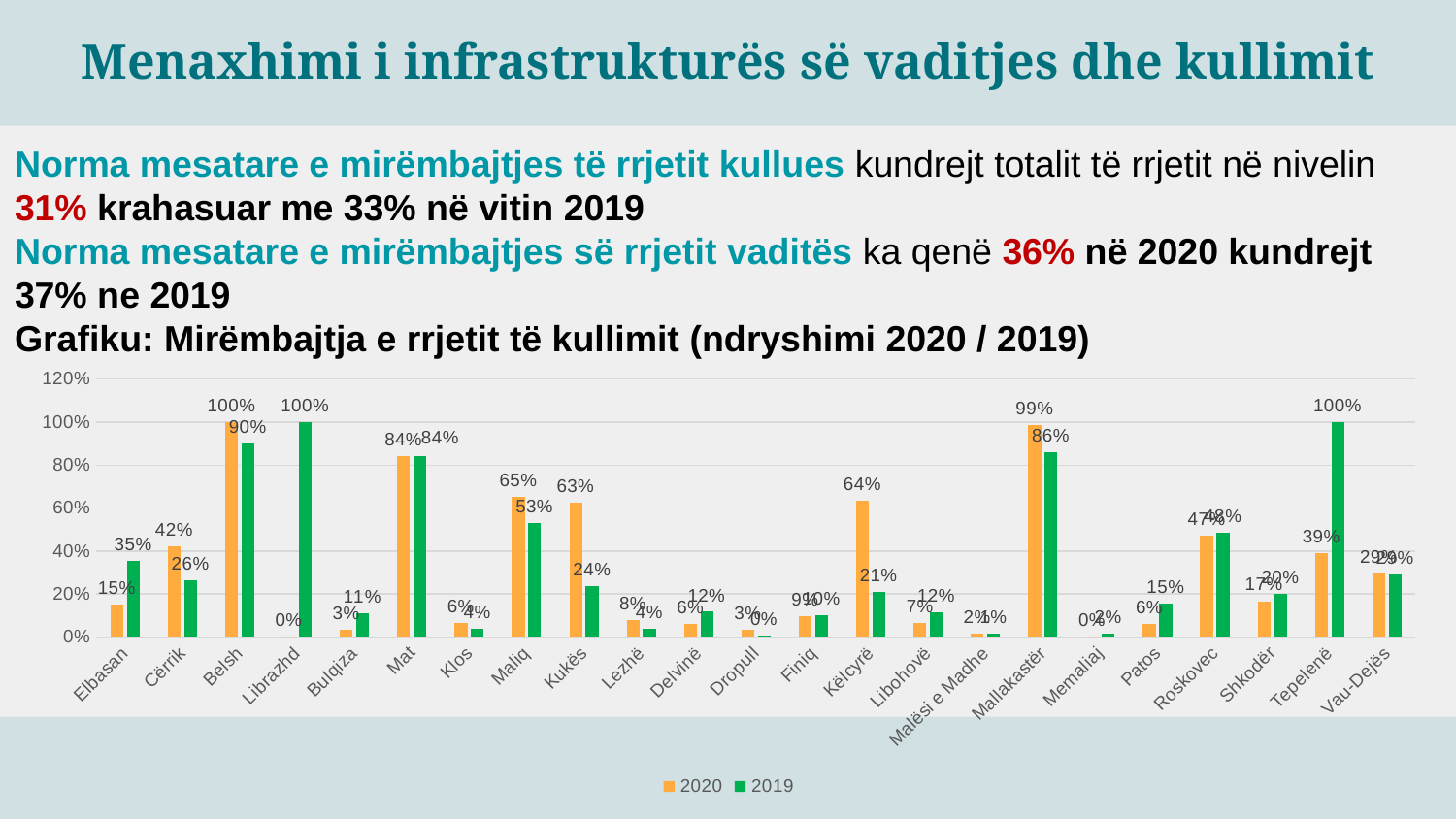
What is the 2020 value for Belsh? 100% Is the 2020 value for Këlcyrë greater or less than 60%? greater Which category has the highest 2020 value? Belsh What kind of chart is shown? Bar chart What is the 2020 value for Mallakastër? 99% Which is larger for Tepelenë, the 2020 value or the 2019 value? 2019 How many categories are shown on the x axis? 23 How many series does the legend list? 2 What is the 2020 value for Kukës? 63% What is the difference between the 2020 and 2019 values for Kukës? 39% What is the 2019 value for Elbasan? 35% What is the 2019 value for Librazhd? 100%